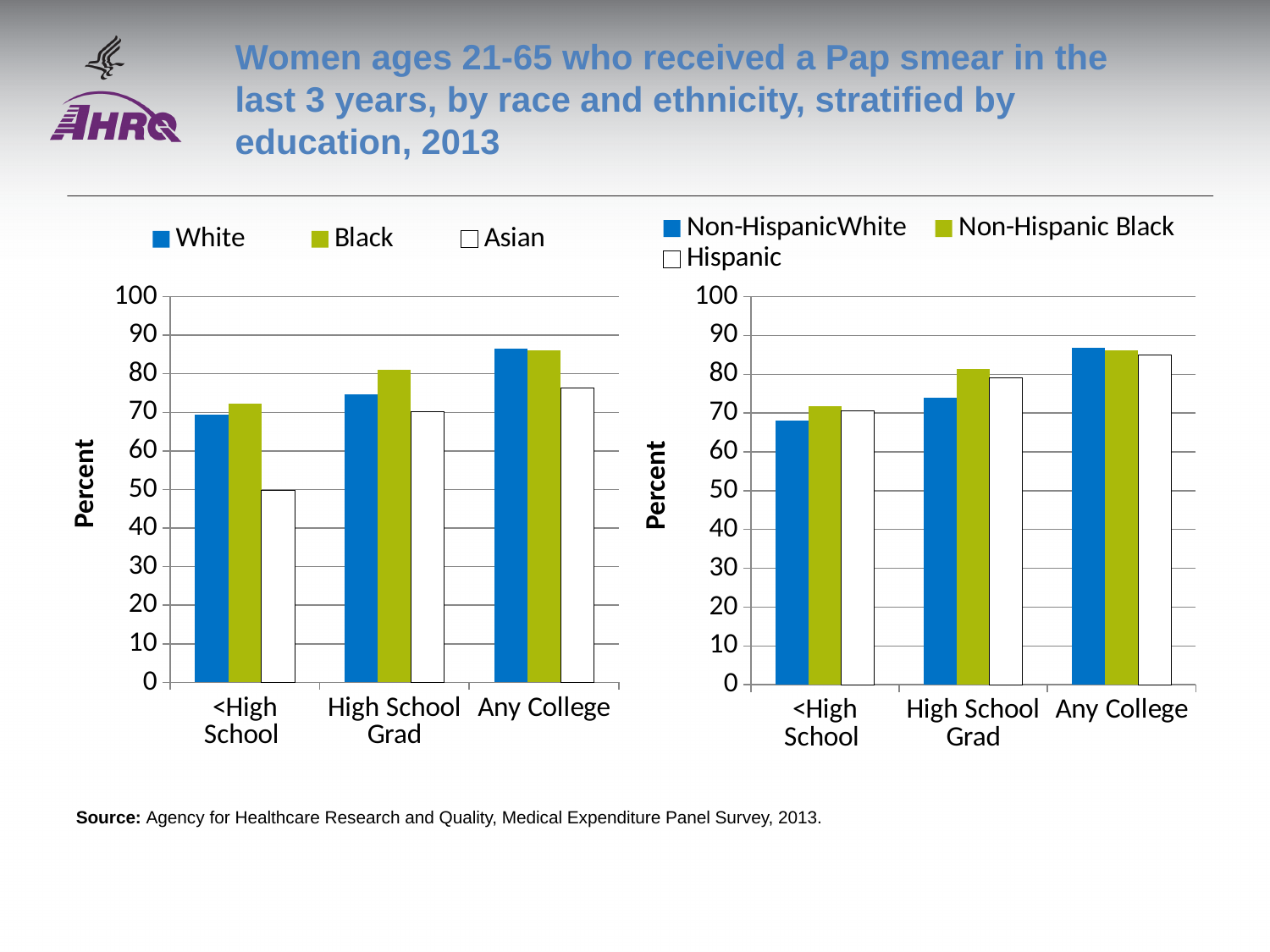
On the left chart, do the values for White rise or fall from <High School to Any College? rise On the left chart, which is larger in the Any College group, Black or Asian? Black On the right chart, how many education categories are shown on the x axis? 3 On the left chart, which series has the lowest value in the <High School group? Asian On the right chart, is the value for Hispanic in the Any College group greater or less than 80? greater On the left chart, how many series does the legend list? 3 On the right chart, which series has the highest value in the High School Grad group? Non-Hispanic Black On the right chart, is the value for Non-Hispanic White in the <High School group greater or less than 70? less On the right chart, what is the label of the y axis? Percent On the left chart, is the value for Asian in the <High School group greater or less than 60? less On the left chart, what kind of chart is shown? bar chart